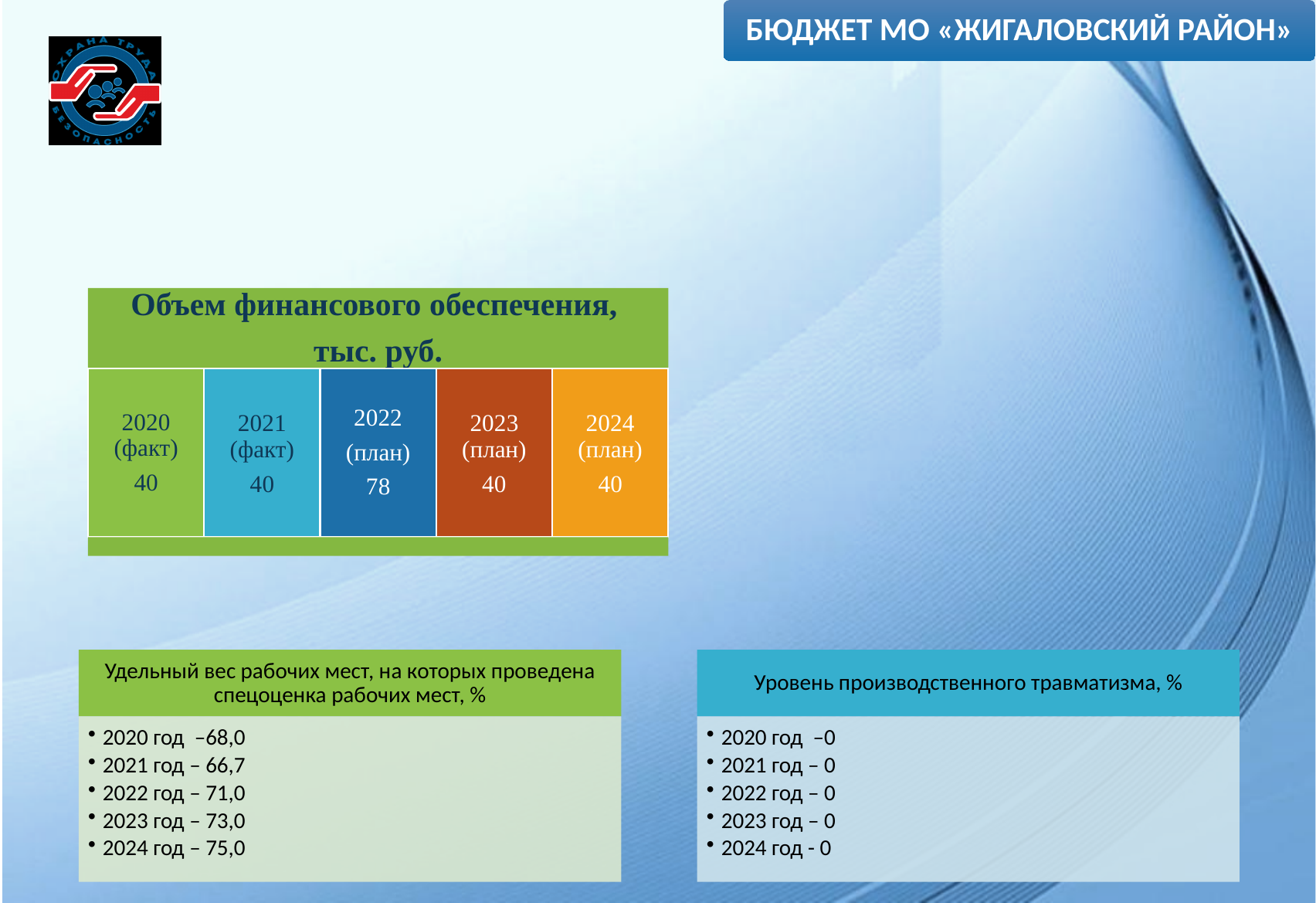
In the chart 'Объем финансового обеспечения, тыс. руб.', is the value for 2022 (план) greater or less than 50? greater In the chart 'Объем финансового обеспечения, тыс. руб.', which year has the highest value? 2022 (план) In the chart 'Объем финансового обеспечения, тыс. руб.', what is the difference between the values for 2022 (план) and 2023 (план)? 38 In the chart 'Объем финансового обеспечения, тыс. руб.', what is the value for 2022 (план)? 78 In the chart 'Объем финансового обеспечения, тыс. руб.', how many years are marked as 'план'? 3 In the chart 'Объем финансового обеспечения, тыс. руб.', what is the total of the values for all five years? 238 In the chart 'Объем финансового обеспечения, тыс. руб.', what is the value for 2024 (план)? 40 In the chart 'Объем финансового обеспечения, тыс. руб.', which is larger: the value for 2021 (факт) or 2022 (план)? 2022 (план) In the chart 'Объем финансового обеспечения, тыс. руб.', what colour is the block for 2023 (план)? Dark orange (brown-red) How many years are shown in the chart 'Объем финансового обеспечения, тыс. руб.'? 5 In the chart 'Объем финансового обеспечения, тыс. руб.', what is the value for 2020 (факт)? 40 What is the title of the chart on the slide? Объем финансового обеспечения, тыс. руб.